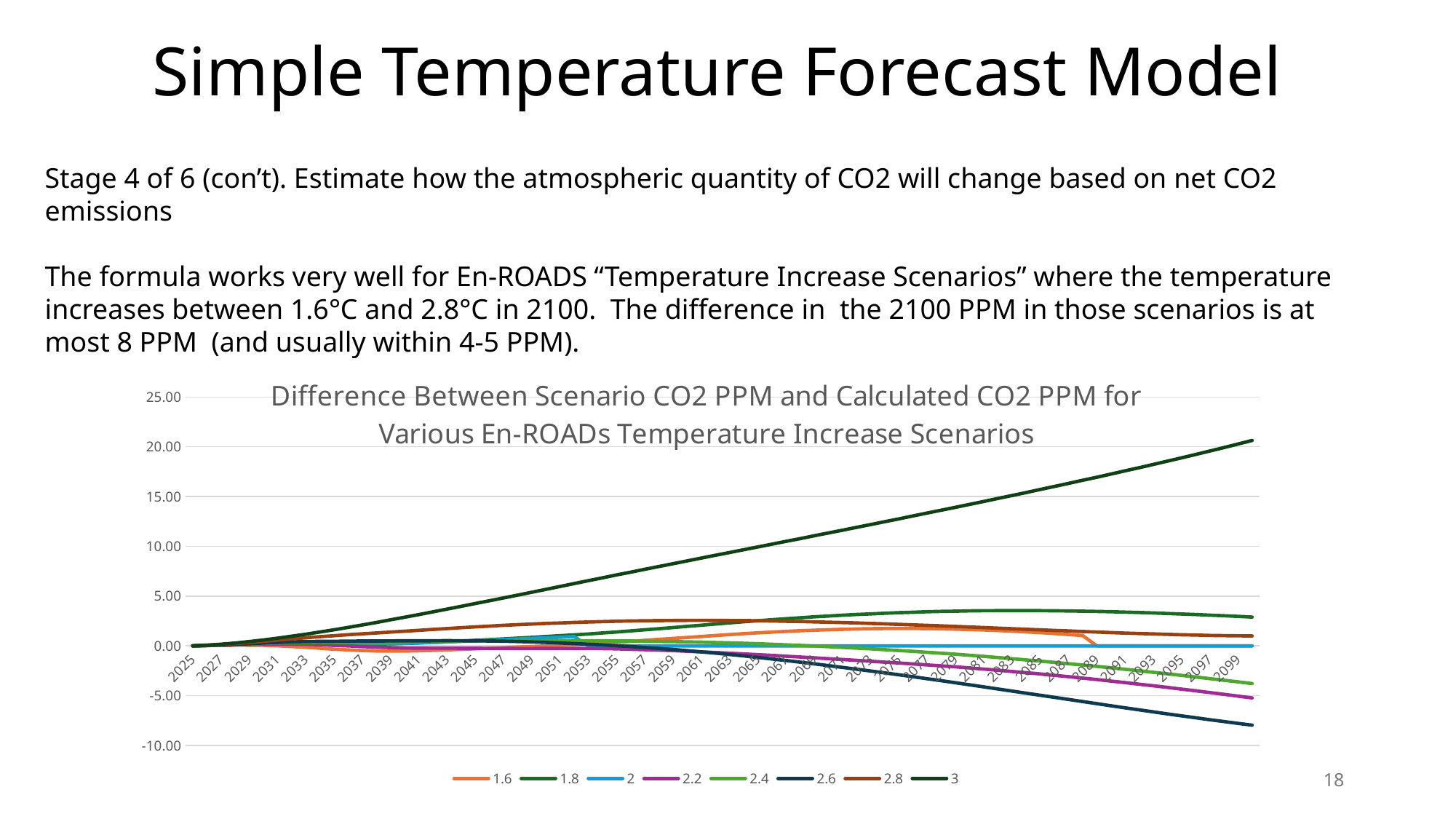
What kind of chart is shown on the slide? Line chart Is the value for series 2.6 at 2099 greater or less than -5.00? less Is the value for series 1.8 at 2083 greater or less than 5.00? less Does the value for series 2.6 rise or fall from 2061 to 2099? fall Which series has the highest value at 2099? 3 Does the value for series 3 rise or fall from 2025 to 2099? rise At 2099, which series has the larger value, 1.8 or 2.8? 1.8 What is the title of the chart? Difference Between Scenario CO2 PPM and Calculated CO2 PPM for Various En-ROADs Temperature Increase Scenarios Is the value for series 3 at 2099 greater or less than 15.00? greater What is the highest value shown on the vertical axis? 25.00 How many series does the chart legend list? 8 Which series has the lowest value at 2099? 2.6